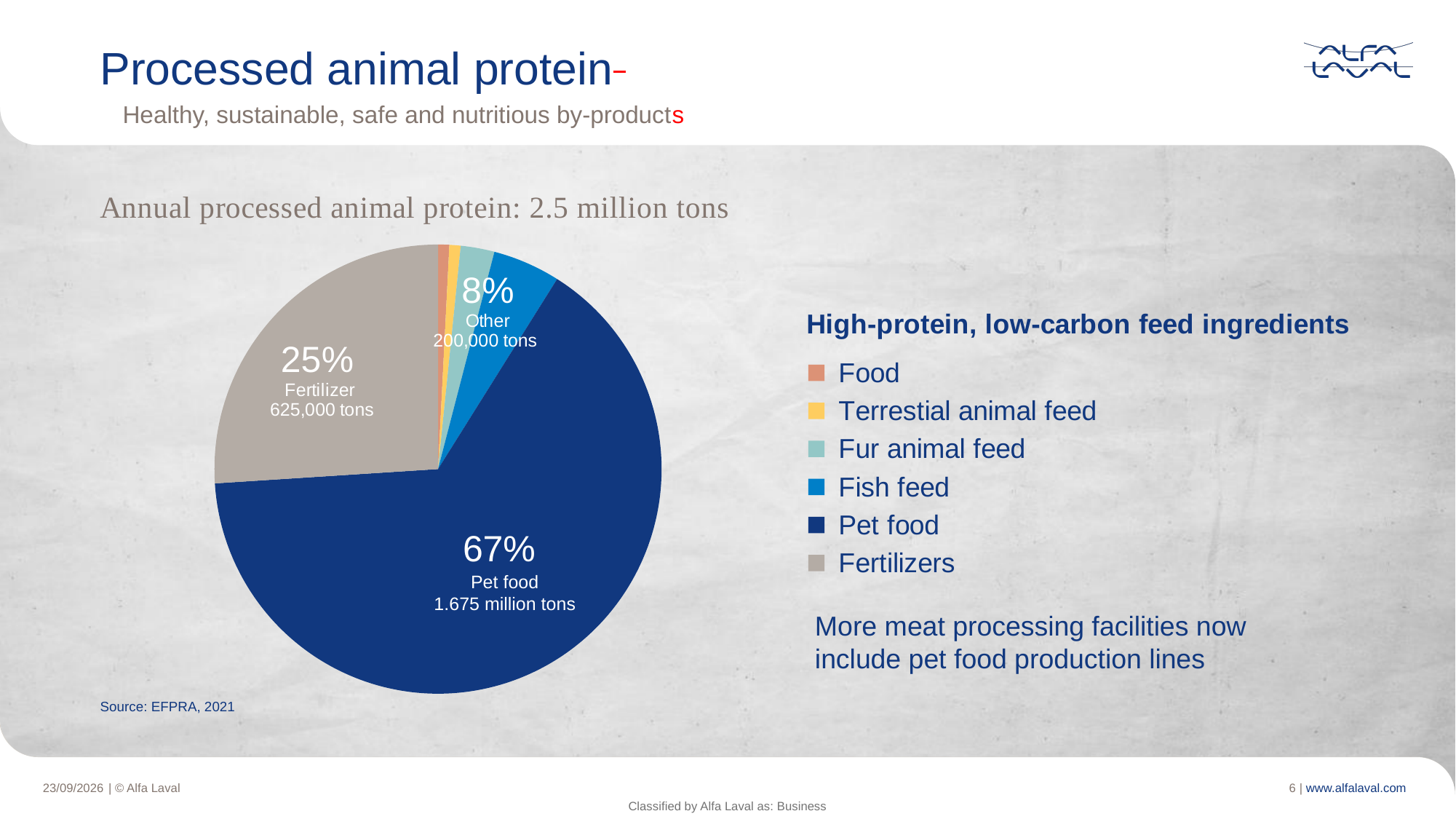
Which is larger, the Pet food share or the Fertilizer share? Pet food How many tons of processed animal protein go to Pet food according to the chart? 1.675 million tons What share of the pie does Fertilizer account for? 25% How many tons of processed animal protein go to Fertilizer according to the chart? 625,000 tons How many tons are in the Other segment of the pie? 200,000 tons What kind of chart is shown on the slide? pie chart What share of the pie does Pet food account for? 67% How many entries does the legend next to the pie chart list? 6 By how many percentage points does the Pet food share exceed the Fertilizer share? 42 Which labelled segment of the pie is the largest? Pet food What share of the pie is labelled Other? 8% Which labelled segment of the pie is the smallest? Other